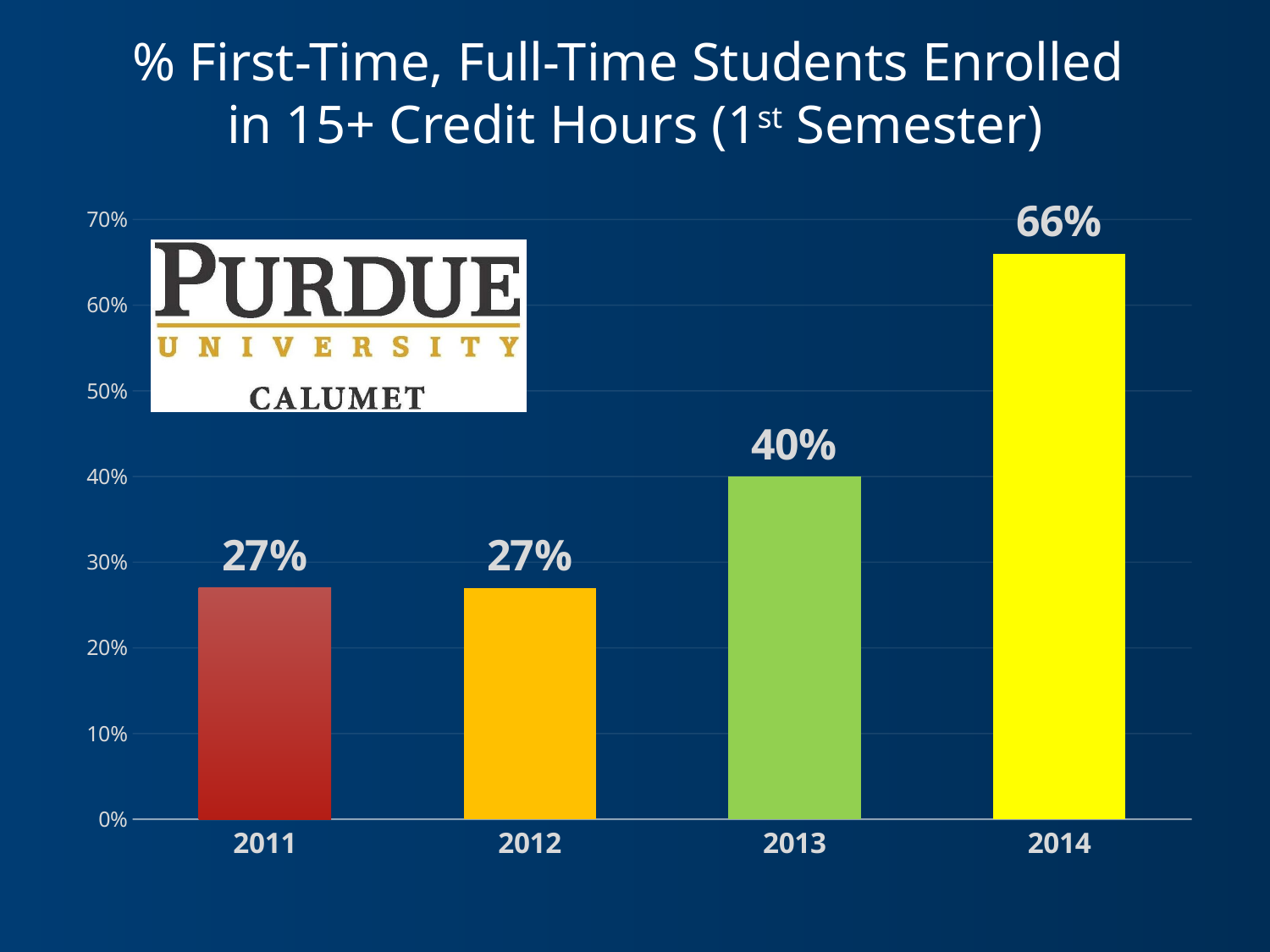
What kind of chart is shown on the slide? Bar chart Which is larger, the value for 2013 or the value for 2012? 2013 What is the difference between the 2014 value and the 2013 value? 26% Do the values rise or fall from 2012 to 2014? Rise What is the value shown for 2011? 27% Is the value for 2014 greater or less than 60%? greater Which year has the highest percentage of students enrolled in 15+ credit hours? 2014 What colour is the bar for 2013? Green What is the difference between the 2013 value and the 2012 value? 13% How many years are shown on the x axis? 4 What percentage of first-time, full-time students were enrolled in 15+ credit hours in 2014? 66% What is the value shown for 2013? 40%